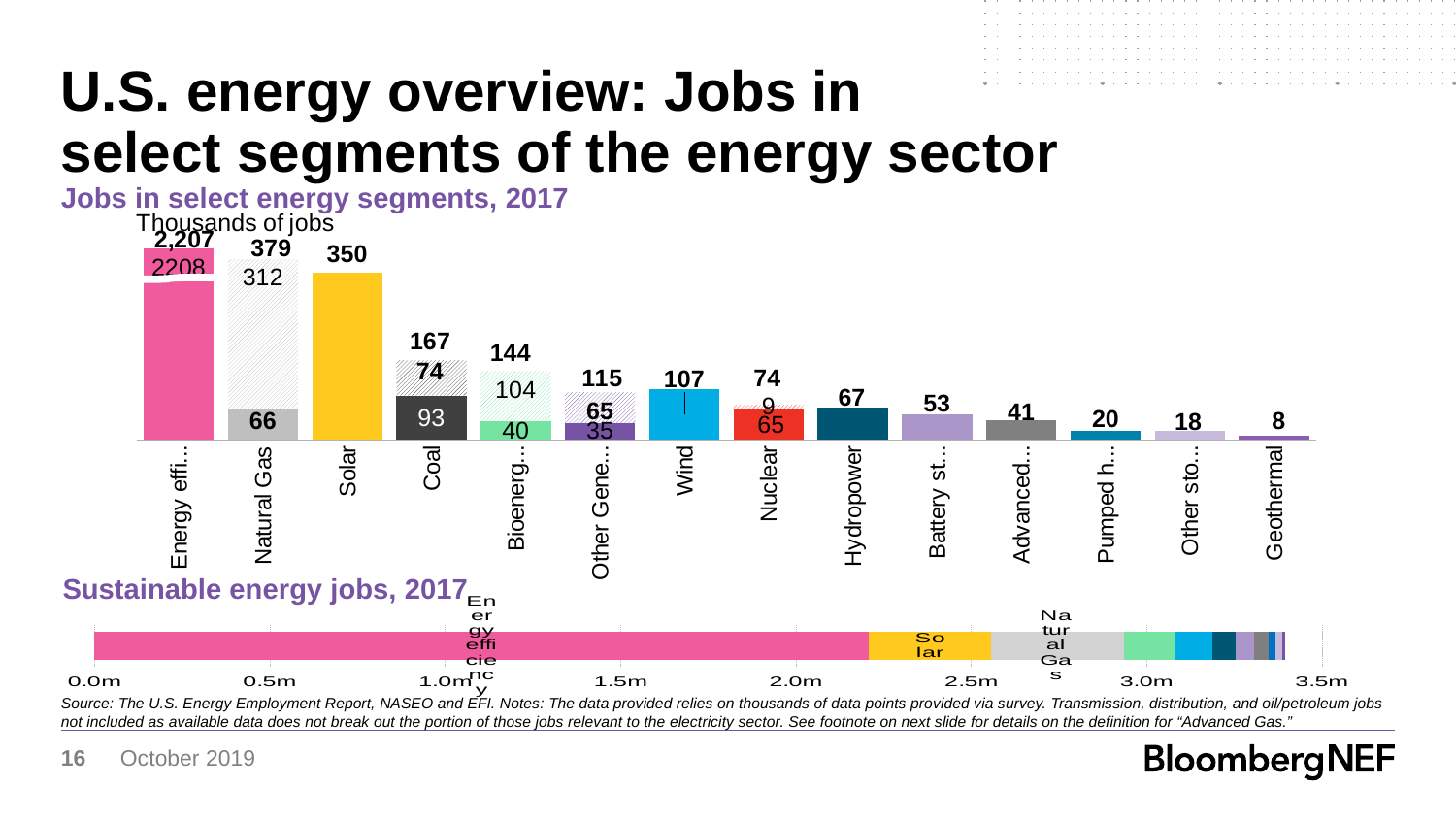
In the 'Jobs in select energy segments, 2017' chart, which category has the lowest value? Geothermal In the 'Jobs in select energy segments, 2017' chart, what is the value for Solar? 350 In the 'Jobs in select energy segments, 2017' chart, do the values rise or fall from left to right along the x axis? Fall In the 'Jobs in select energy segments, 2017' chart, which is larger, the value for Wind or the value for Nuclear? Wind In the 'Jobs in select energy segments, 2017' chart, what is the value for Hydropower? 67 In the 'Sustainable energy jobs, 2017' chart, is the total length of the stacked bar greater or less than 3.0m? greater In the 'Jobs in select energy segments, 2017' chart, which category has the highest value? Energy efficiency In the 'Jobs in select energy segments, 2017' chart, what is the value for Wind? 107 In the 'Jobs in select energy segments, 2017' chart, what is the value for Geothermal? 8 What kind of chart is 'Jobs in select energy segments, 2017'? Bar chart In the 'Jobs in select energy segments, 2017' chart, what is the difference between the Solar value and the Wind value? 243 How many categories are shown in the 'Jobs in select energy segments, 2017' chart? 14